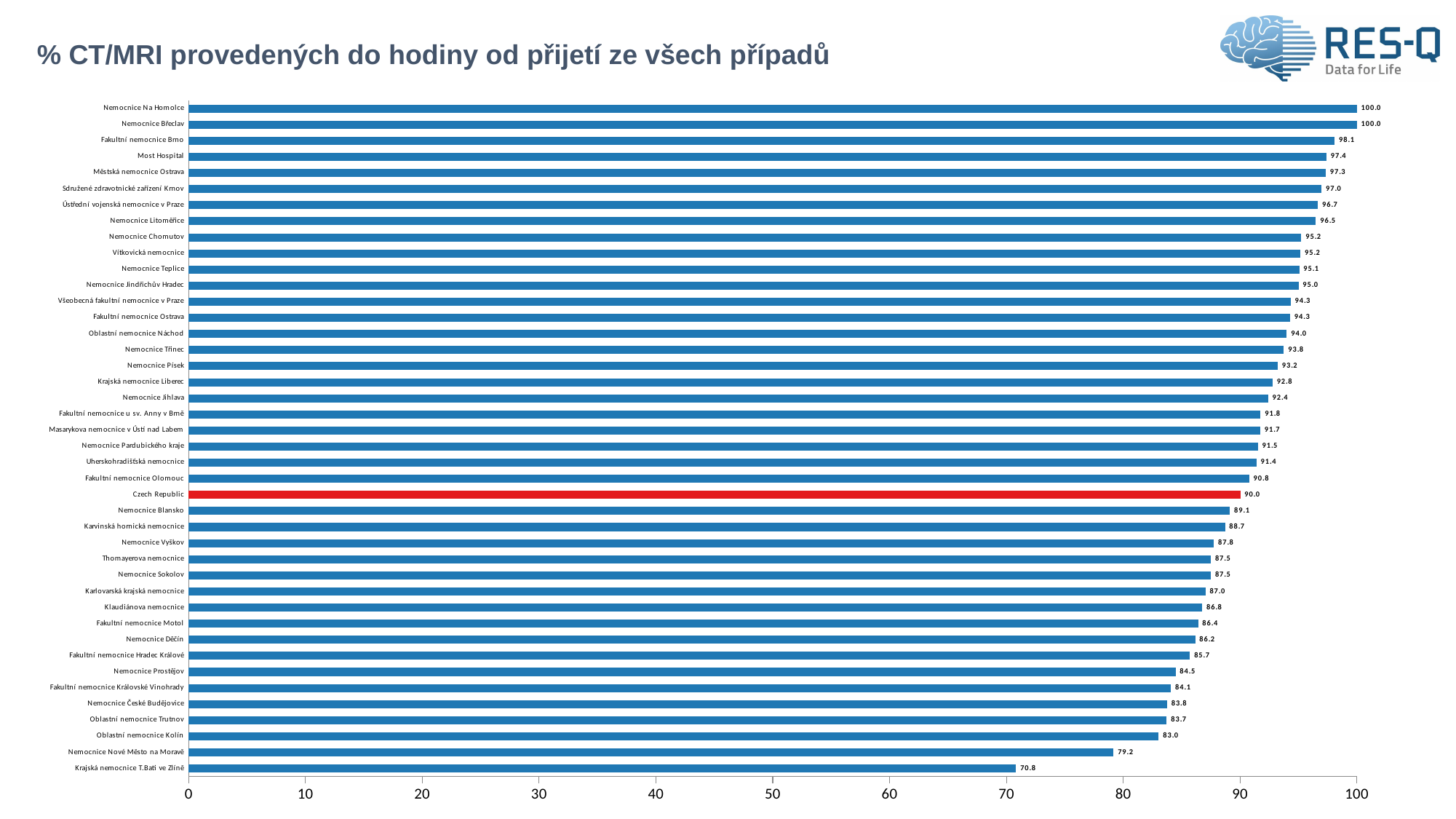
What kind of chart is shown on the slide? bar chart What is the difference between the values for Fakultní nemocnice Brno and Fakultní nemocnice Olomouc? 7.3 How many bars are shown on the chart? 42 What is the title of the chart? % CT/MRI provedených do hodiny od přijetí ze všech případů Which bar is highlighted in red? Czech Republic What is the value for Nemocnice Nové Město na Moravě? 79.2 What is the value for Fakultní nemocnice Motol? 86.4 Is the value for Oblastní nemocnice Kolín greater or less than 90? less What is the highest value shown on the chart? 100.0 Which hospital has the lowest value? Krajská nemocnice T.Bati ve Zlíně Which is larger, the value for Nemocnice Blansko or the value for Nemocnice Vyškov? Nemocnice Blansko What is the value for Czech Republic? 90.0